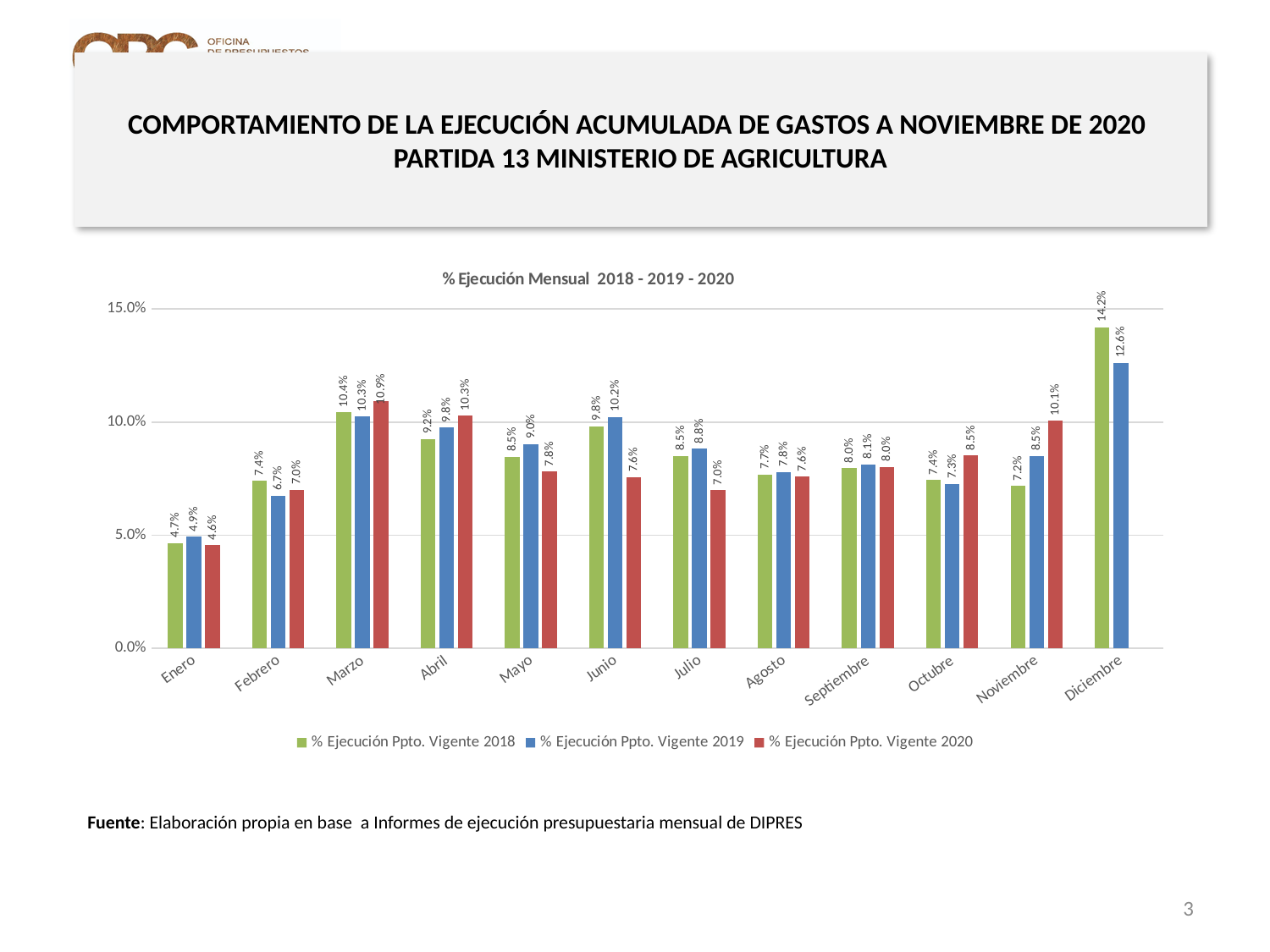
What is the value for % Ejecución Ppto. Vigente 2020 in Marzo? 10.9% Is the value for % Ejecución Ppto. Vigente 2019 in Diciembre greater or less than 10.0%? greater What is the title of the chart? % Ejecución Mensual 2018 - 2019 - 2020 In Junio, which is larger: the 2019 value or the 2020 value? 2019 How many months are shown on the x axis? 12 What is the value for % Ejecución Ppto. Vigente 2018 in Diciembre? 14.2% What is the difference between the 2020 and 2018 values in Noviembre? 2.9% Which month has the lowest value for % Ejecución Ppto. Vigente 2018? Enero What kind of chart is shown on the slide? Bar chart Which month has the highest value for % Ejecución Ppto. Vigente 2020? Marzo What is the value for % Ejecución Ppto. Vigente 2019 in Noviembre? 8.5% How many series does the legend list? 3